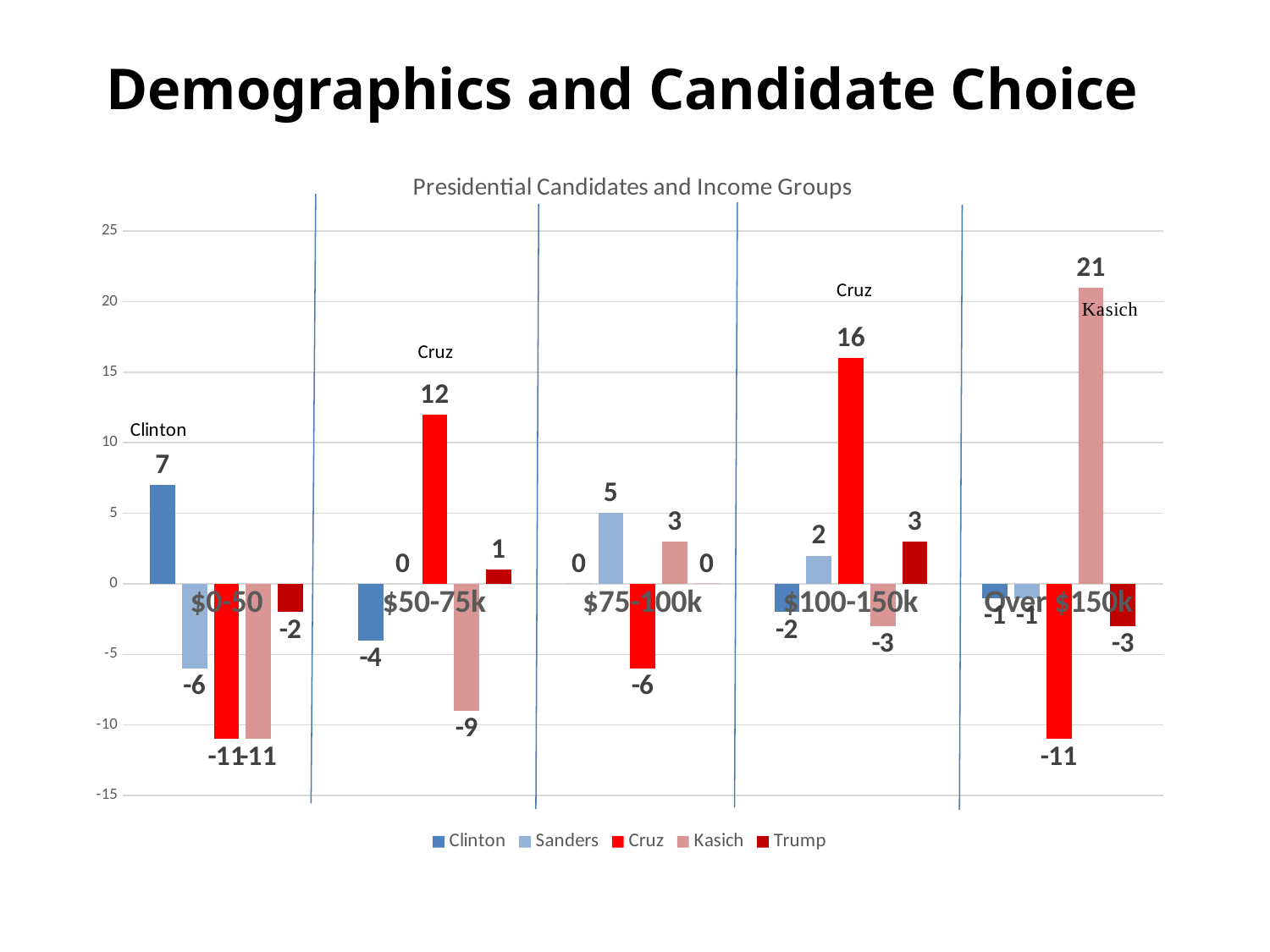
What is the value for Clinton in the $0-50 income group? 7 What is the difference between the Cruz value in the $100-150k group and the Cruz value in the $50-75k group? 4 Which is larger: the Kasich value in the Over $150k group or the Cruz value in the $100-150k group? Kasich in Over $150k Which income group has the highest value for Cruz? $100-150k What is the value for Cruz in the $100-150k income group? 16 What is the value for Sanders in the $75-100k income group? 5 What kind of chart is shown on the slide? Bar chart What is the value for Kasich in the Over $150k income group? 21 How many series does the legend list? 5 Which income group has the lowest value for Kasich? $0-50 What is the title of the chart? Presidential Candidates and Income Groups How many income groups are shown on the x axis? 5